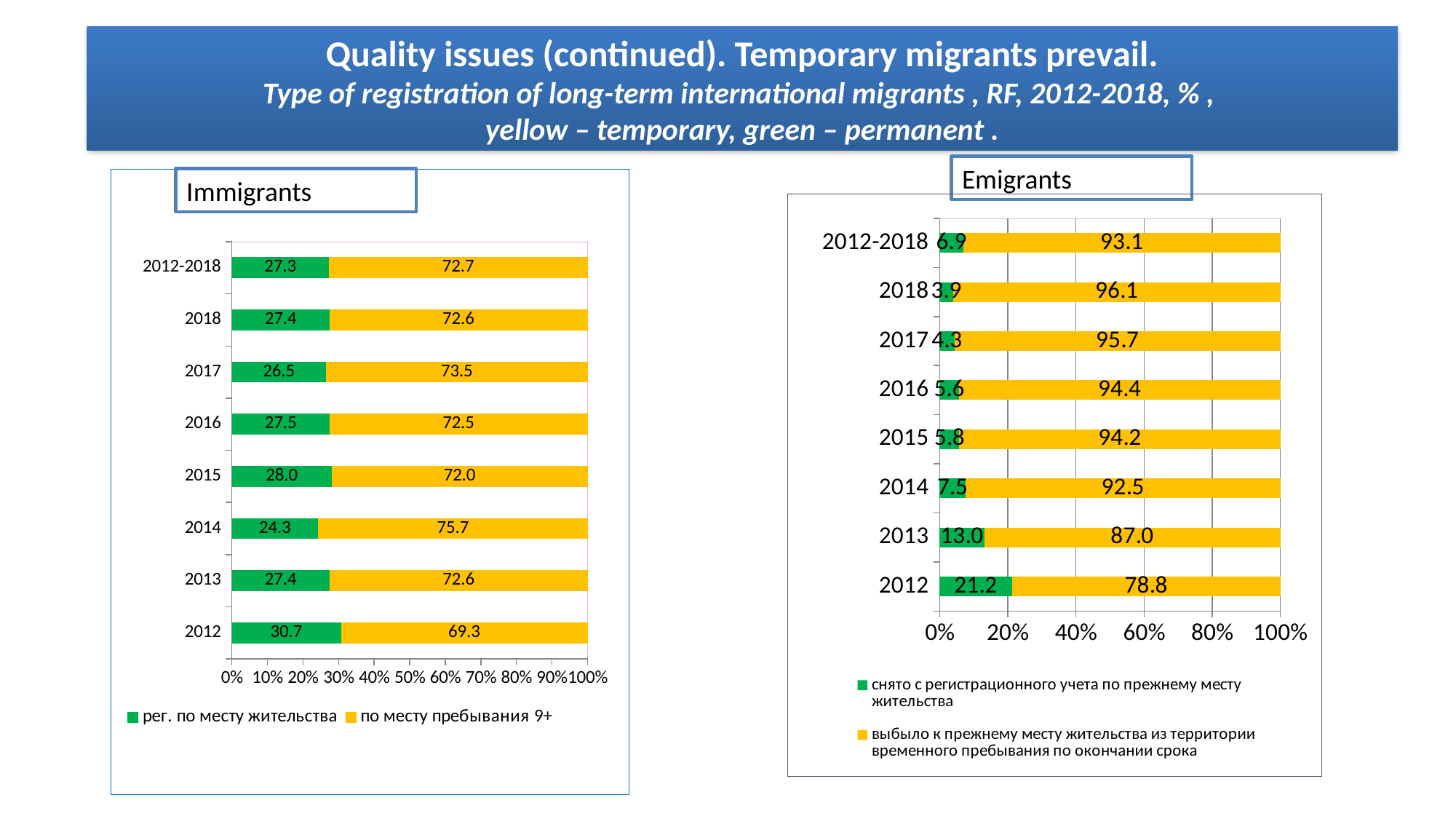
In the Emigrants chart, what is the green (permanent) value for 2012-2018? 6.9 How many bars (categories) does the Immigrants chart show? 8 In the Immigrants chart, what is the yellow (temporary) value for 2014? 75.7 In the Emigrants chart, what is the difference between the green values for 2012 and 2013? 8.2 In the Immigrants chart, what is the green (permanent) value for 2012? 30.7 In the Emigrants chart, which year has the highest green (permanent) value? 2012 In the Emigrants chart, what is the yellow (temporary) value for 2018? 96.1 In the Immigrants chart, what is the difference between the yellow and green values for 2012? 38.6 In the Emigrants chart, which year has the lowest green (permanent) value? 2018 What type of chart is the Emigrants chart? Stacked bar chart In the Immigrants chart, which year has the lowest green (permanent) value? 2014 Which is larger: the green value for 2013 in the Emigrants chart or the green value for 2014 in the Emigrants chart? 2013